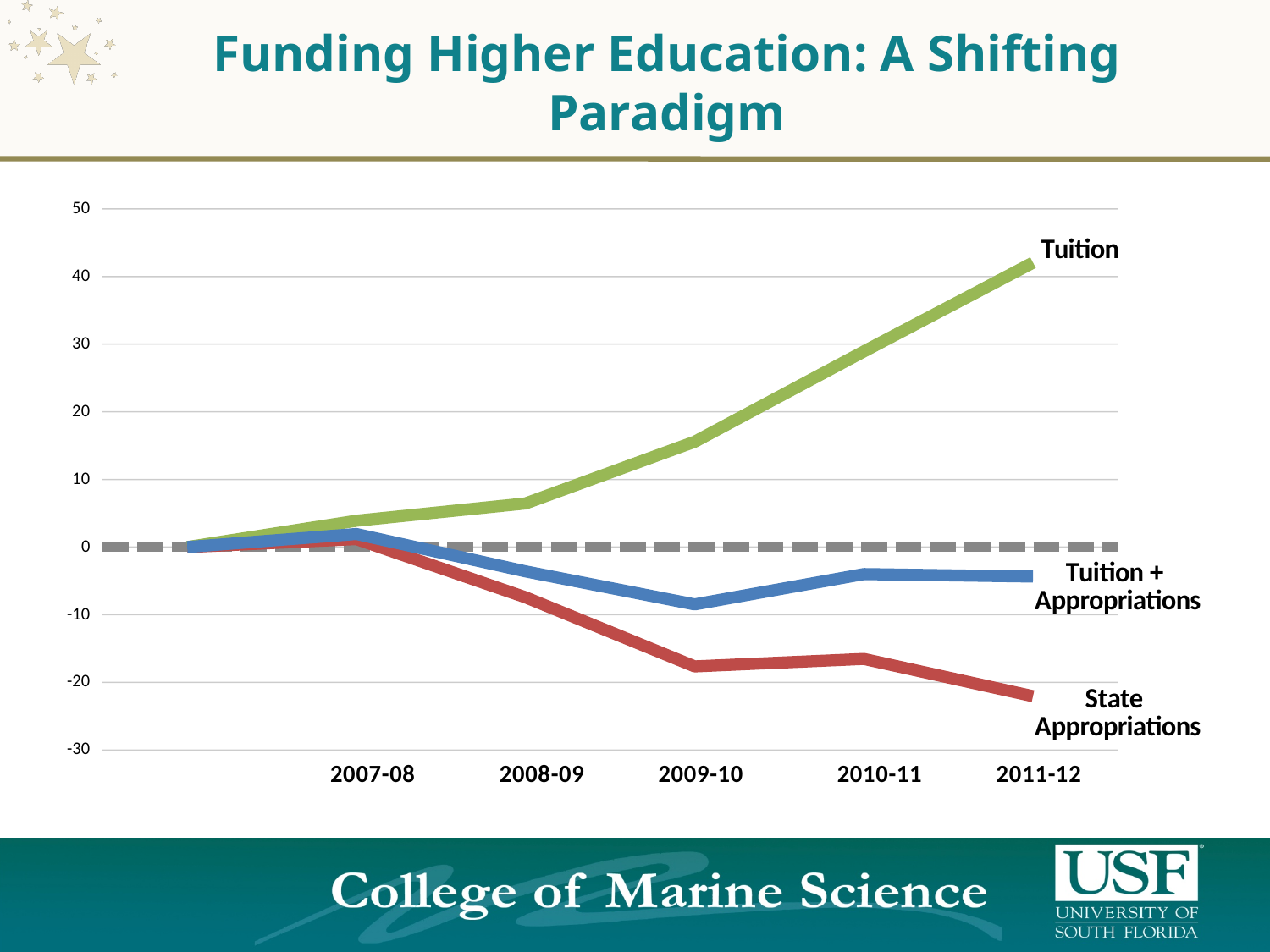
Does the Tuition line rise or fall from 2007-08 to 2011-12? Rises What is the title of the slide containing the chart? Funding Higher Education: A Shifting Paradigm How many data series are plotted on the chart? 3 What kind of chart is shown on the slide? Line chart Is the value for Tuition + Appropriations in 2009-10 greater or less than 0? less How many labeled academic years appear on the x axis? 5 Does the State Appropriations line rise or fall from 2007-08 to 2011-12? Falls Is the value for Tuition in 2011-12 greater or less than 40? greater Which series has the highest value in 2011-12? Tuition Is the value for Tuition in 2009-10 greater or less than 10? greater Which series has the lowest value in 2010-11? State Appropriations